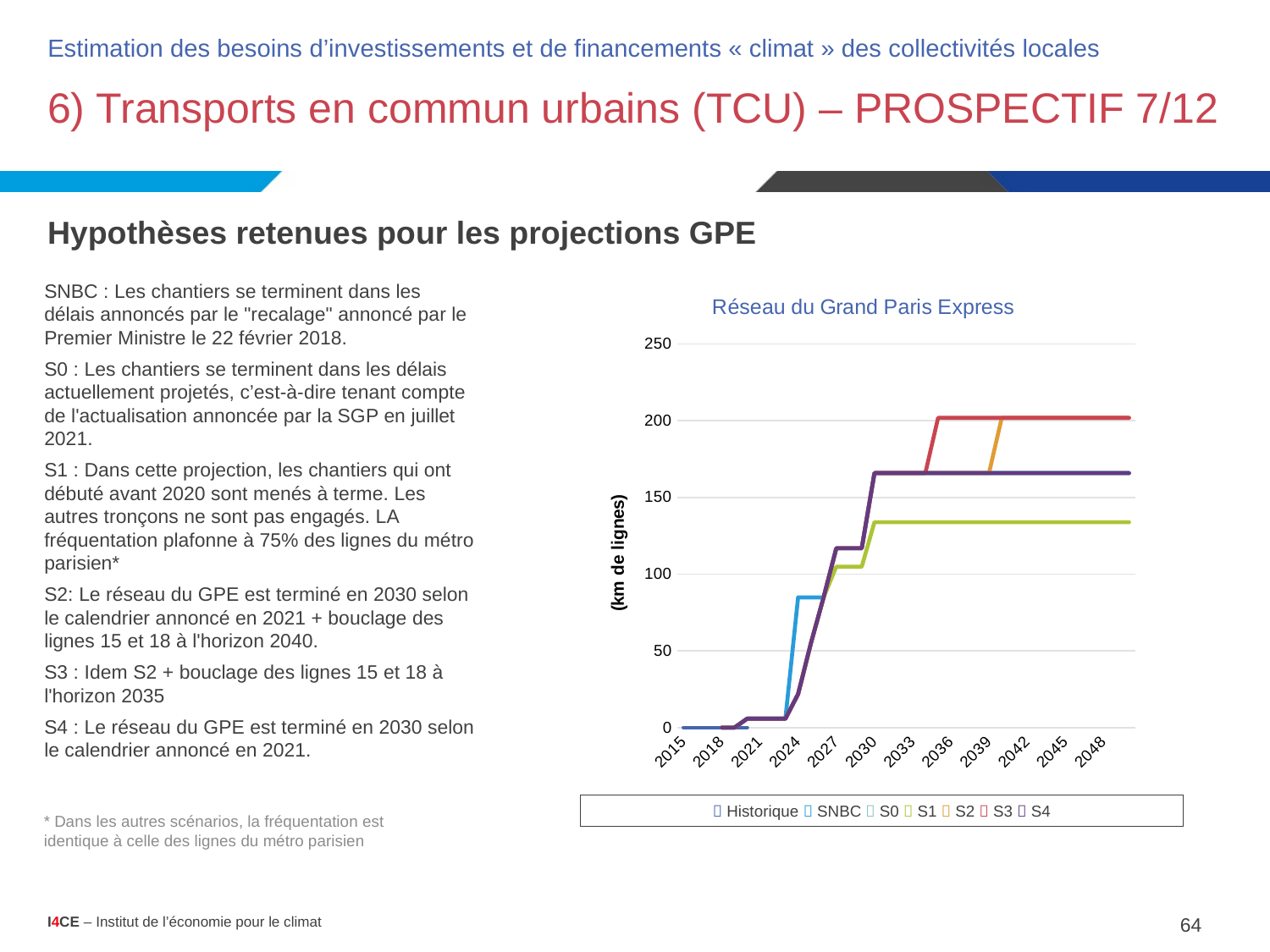
How many year labels are shown on the horizontal axis of the chart? 12 Is the value for S1 in 2045 greater or less than 100? greater Is the value for S1 in 2045 greater or less than 150? less Which series has the larger value in 2045, S3 or S1? S3 What kind of chart is shown on the slide? line chart Is the value for S3 in 2045 greater or less than 150? greater What is the label of the vertical axis of the chart? (km de lignes) How many series does the chart legend list? 7 Do the values for S3 rise or fall from 2015 to 2048? rise Which series has the larger value in 2036, S3 or S2? S3 What is the title of the chart? Réseau du Grand Paris Express